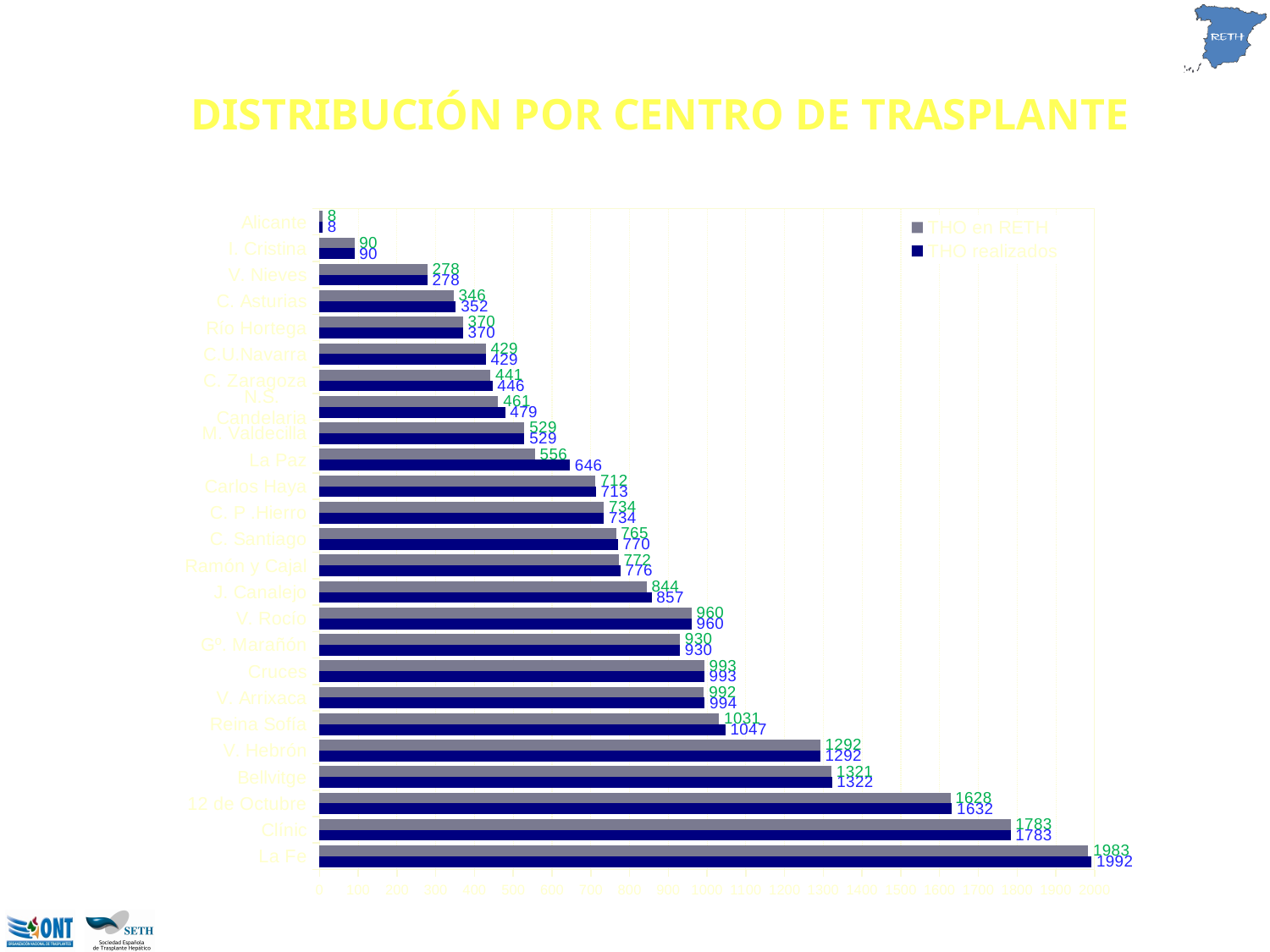
What is the difference between THO realizados and THO en RETH for La Paz? 90 What is the THO realizados value for La Fe? 1992 Which centre has the highest THO realizados value? La Fe What is the THO realizados value for La Paz? 646 How many series does the legend list? 2 What are the two legend entries of the chart? THO en RETH and THO realizados What kind of chart is shown on the slide? bar chart What is the THO en RETH value for 12 de Octubre? 1628 How many transplant centres are shown on the chart? 25 What is the difference between the THO realizados values of Clínic and 12 de Octubre? 151 Which centre has the lowest THO en RETH value? Alicante Which is larger, the THO en RETH value for V. Hebrón or for Reina Sofía? V. Hebrón